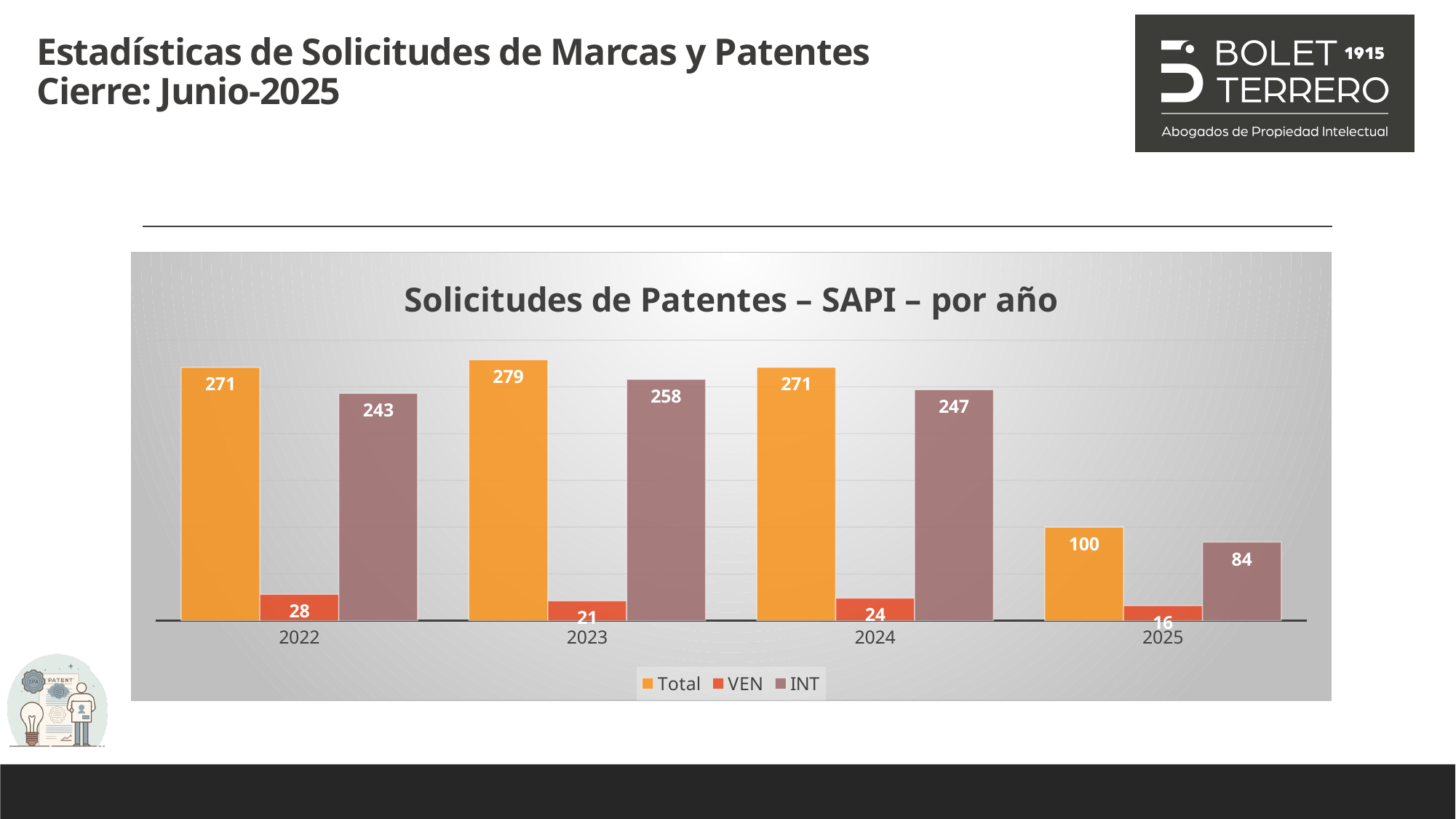
What is the Total value for 2023? 279 Which year has the lowest INT value? 2025 Which year has the highest Total value? 2023 What kind of chart is shown on the slide? Bar chart What is the difference between the Total values for 2024 and 2025? 171 Do the INT values rise or fall from 2023 to 2025? Fall Which is larger, the VEN value for 2022 or the VEN value for 2024? 2022 What is the title of the chart? Solicitudes de Patentes – SAPI – por año What is the VEN value for 2025? 16 How many series does the legend list? 3 How many years are shown on the x axis? 4 What is the INT value for 2022? 243